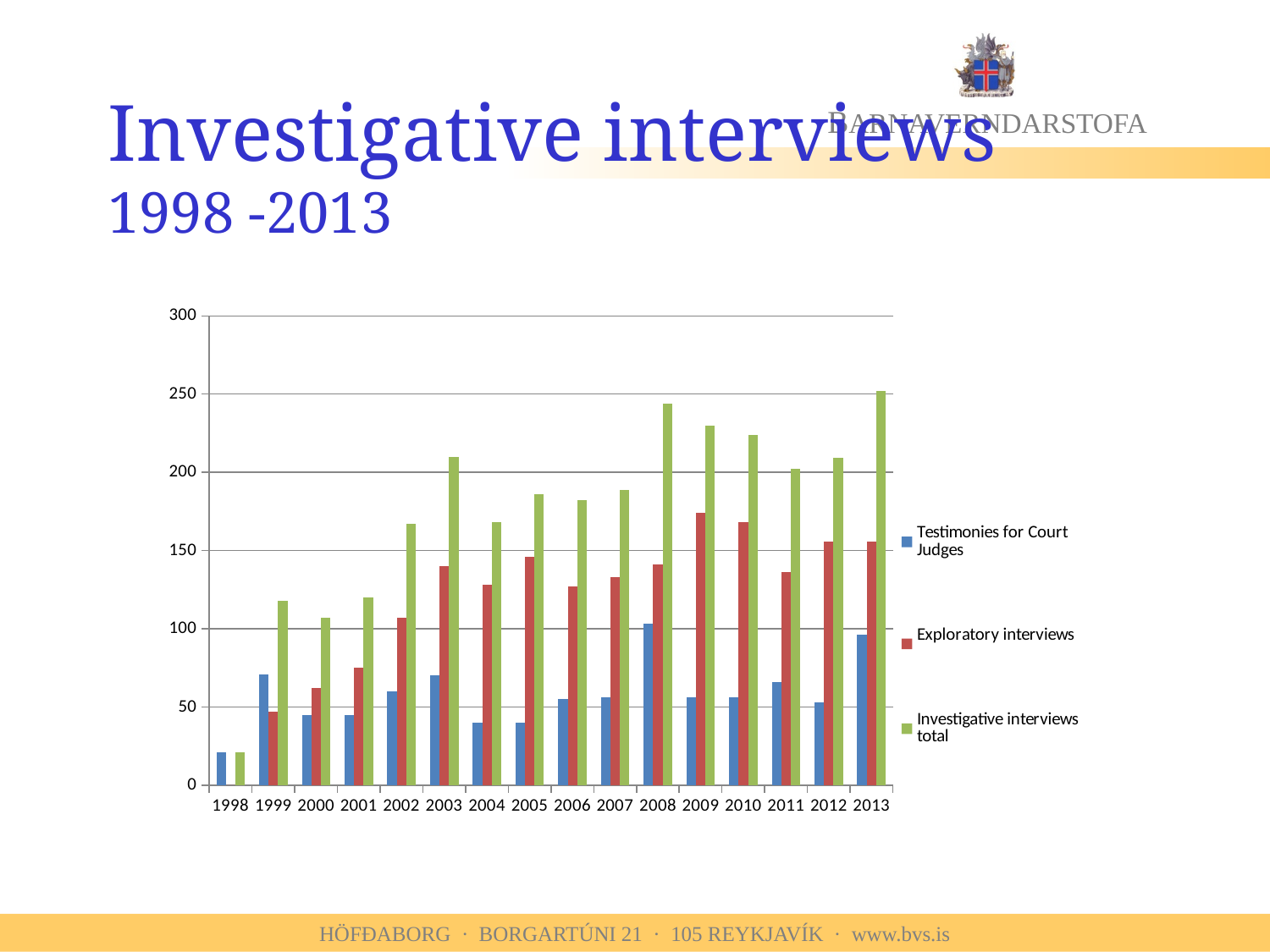
Which year has the larger value for Investigative interviews total, 2003 or 2004? 2003 How many years are shown along the x axis? 16 What kind of chart is shown on the slide? bar chart Which year has the lowest value for Investigative interviews total? 1998 Is the value for Investigative interviews total in 2008 greater or less than 200? greater How many series does the legend list? 3 Is the value for Exploratory interviews in 2000 greater or less than 100? less Is the value for Testimonies for Court Judges in 2013 greater or less than 50? greater What colour represents Investigative interviews total in the legend? green Which year has the larger value for Exploratory interviews, 2009 or 2011? 2009 Which year has the highest value for Investigative interviews total? 2013